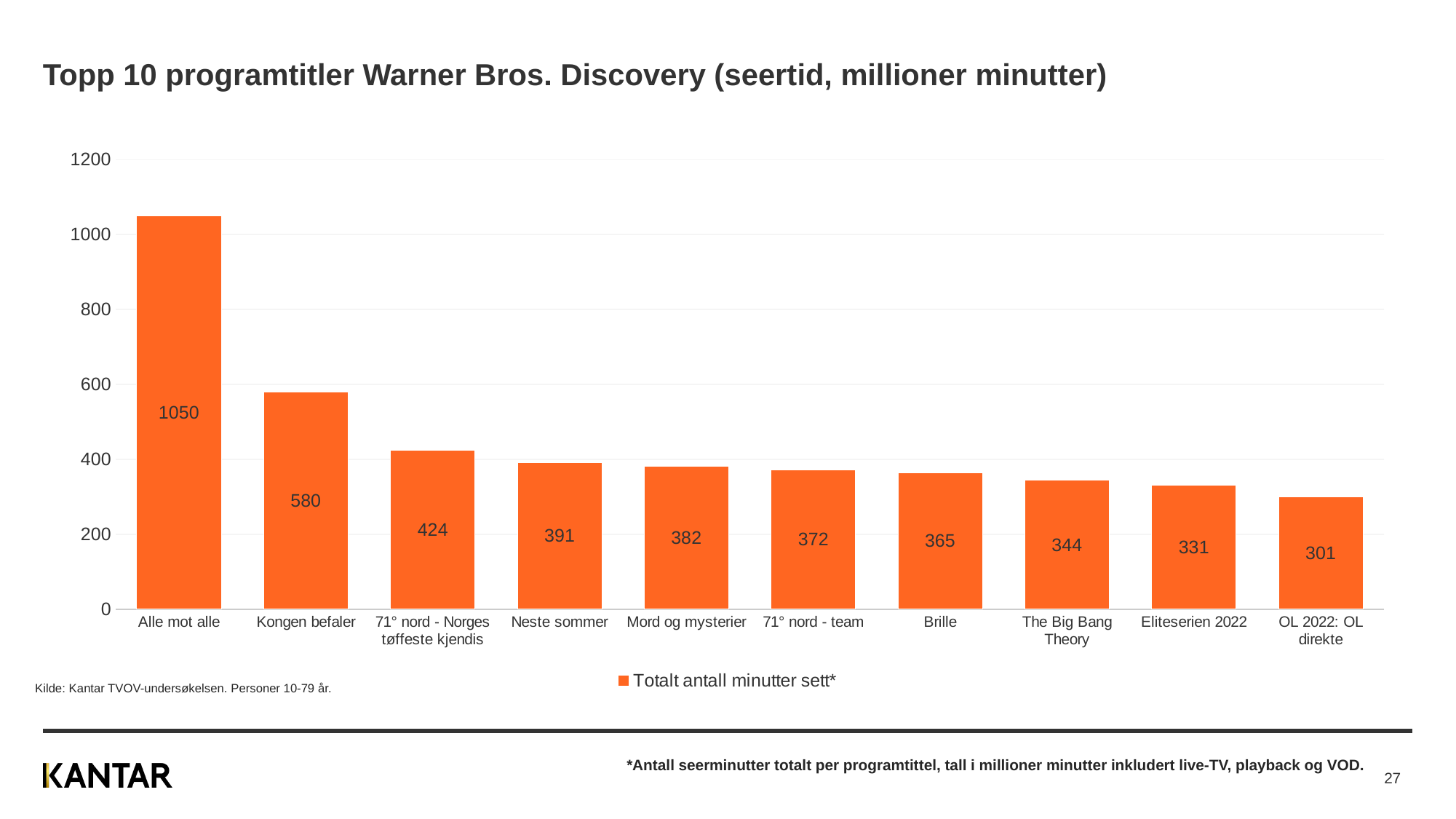
What is the difference between the values for Eliteserien 2022 and OL 2022: OL direkte? 30 How many program titles are shown in the chart? 10 What is the value for Alle mot alle? 1050 What is the difference between the values for Alle mot alle and Kongen befaler? 470 What is the value for Brille? 365 What is the legend entry for the series shown in the chart? Totalt antall minutter sett* Which program title has the highest value? Alle mot alle Which is larger, the value for Neste sommer or the value for 71° nord - team? Neste sommer What is the value for The Big Bang Theory? 344 What kind of chart is shown on the slide? Bar chart What is the value for Kongen befaler? 580 Which program title has the lowest value? OL 2022: OL direkte